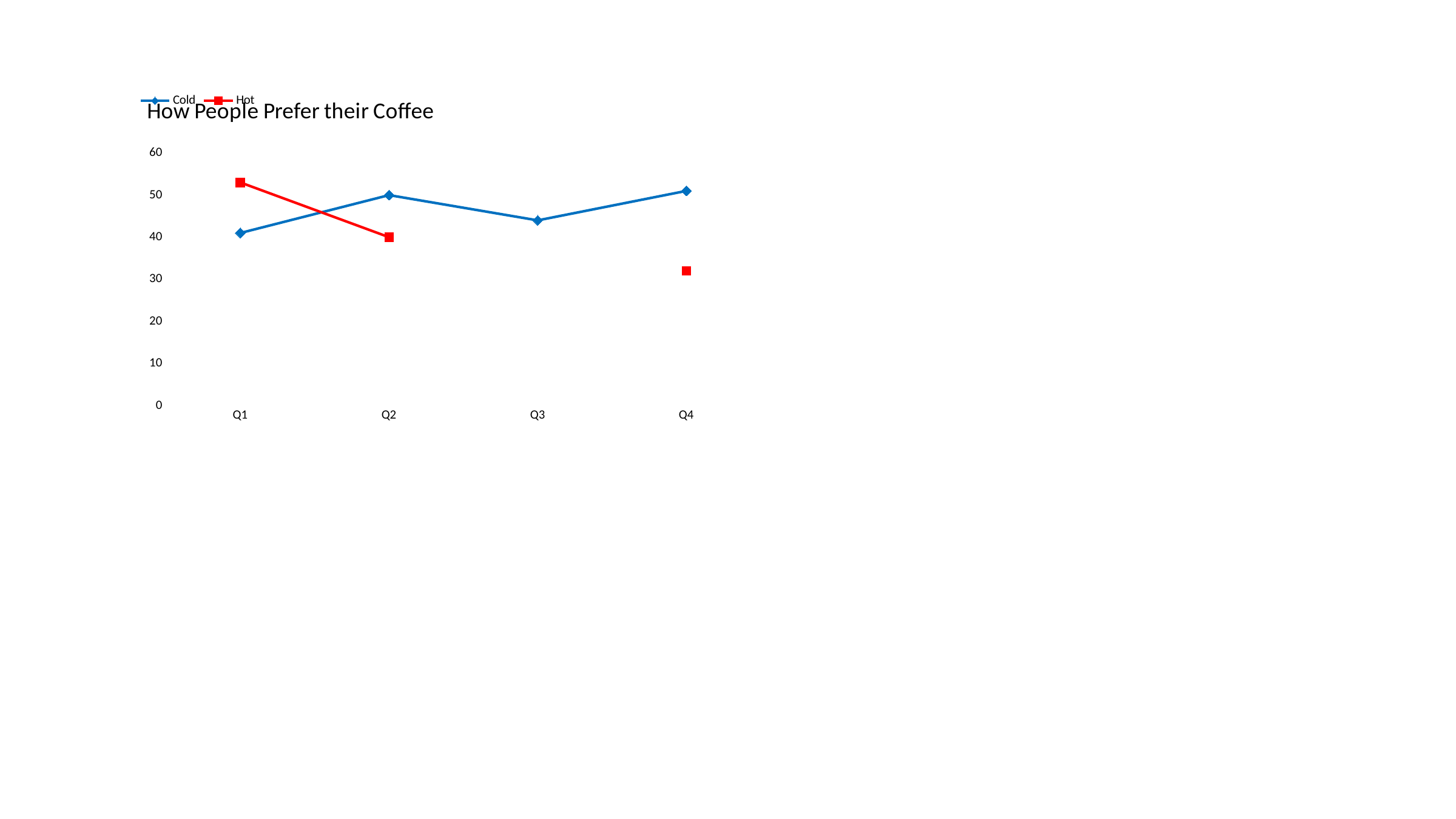
How many series does the legend list? 2 Is the value for Hot in Q4 greater or less than 40? less Does the Hot series rise or fall from Q1 to Q2? fall How many categories are shown on the x axis? 4 In Q1, which series has the larger value, Cold or Hot? Hot What kind of chart is shown on the slide? line chart In Q2, which series has the larger value, Cold or Hot? Cold For the Hot series, which quarter has the highest value? Q1 What is the title of the chart? How People Prefer their Coffee Which series is drawn in red? Hot In Q4, which series has the larger value, Cold or Hot? Cold For the Hot series, which quarter has the lowest value? Q4